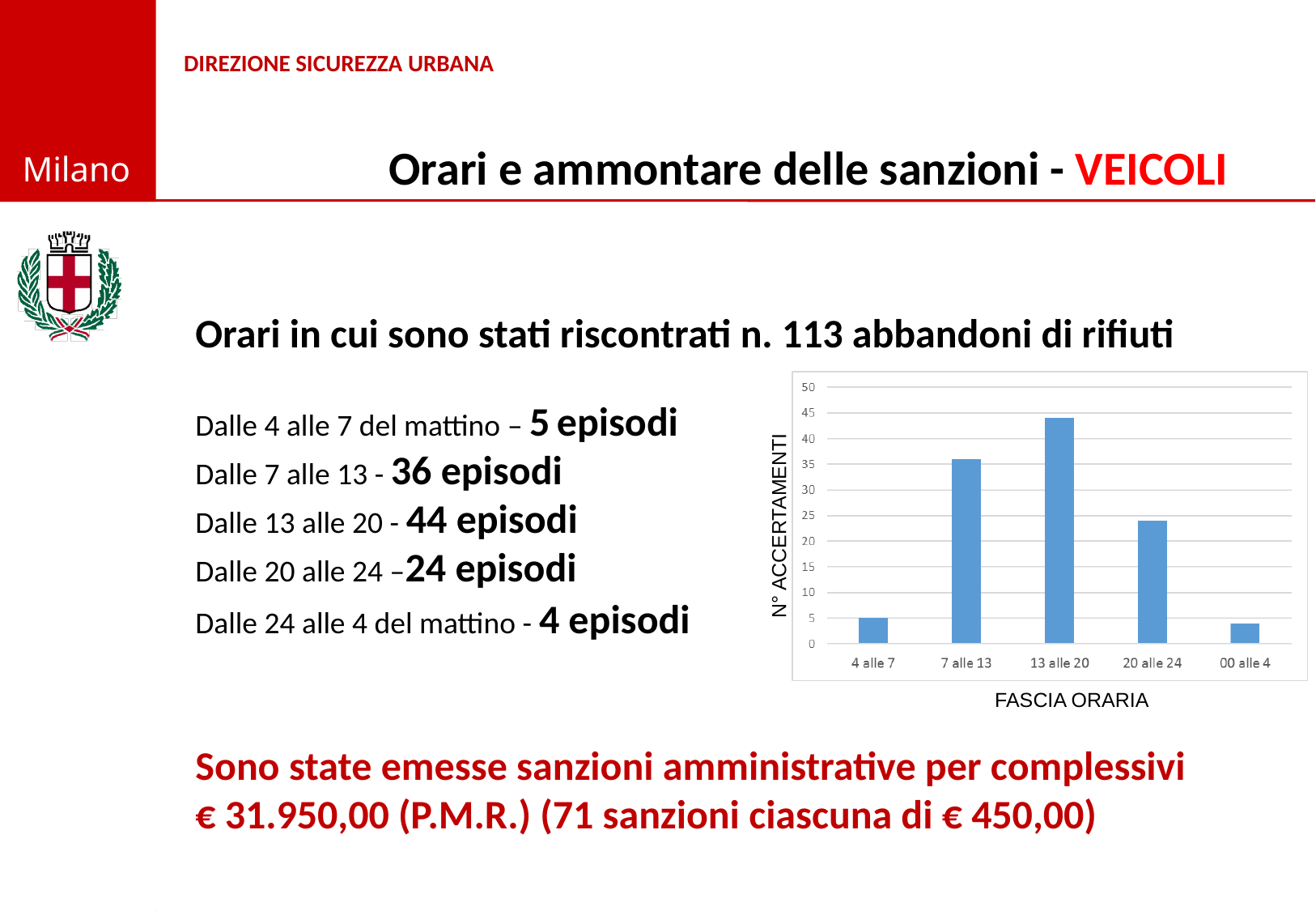
What is the number of accertamenti for the 7 alle 13 time band? 36 What is the number of accertamenti for the 4 alle 7 time band? 5 Which is larger, the value for 7 alle 13 or the value for 20 alle 24? 7 alle 13 What is the number of accertamenti for the 13 alle 20 time band? 44 Is the value for 00 alle 4 greater or less than 5? less How many time bands (categories) are shown on the x axis of the chart? 5 Which time band has the lowest number of accertamenti in the chart? 00 alle 4 What is the difference between the values for 13 alle 20 and 7 alle 13? 8 What kind of chart is shown on the slide? bar chart Which time band has the highest number of accertamenti in the chart? 13 alle 20 Is the value for 20 alle 24 greater or less than 20? greater What is the label of the y axis of the chart? N° ACCERTAMENTI